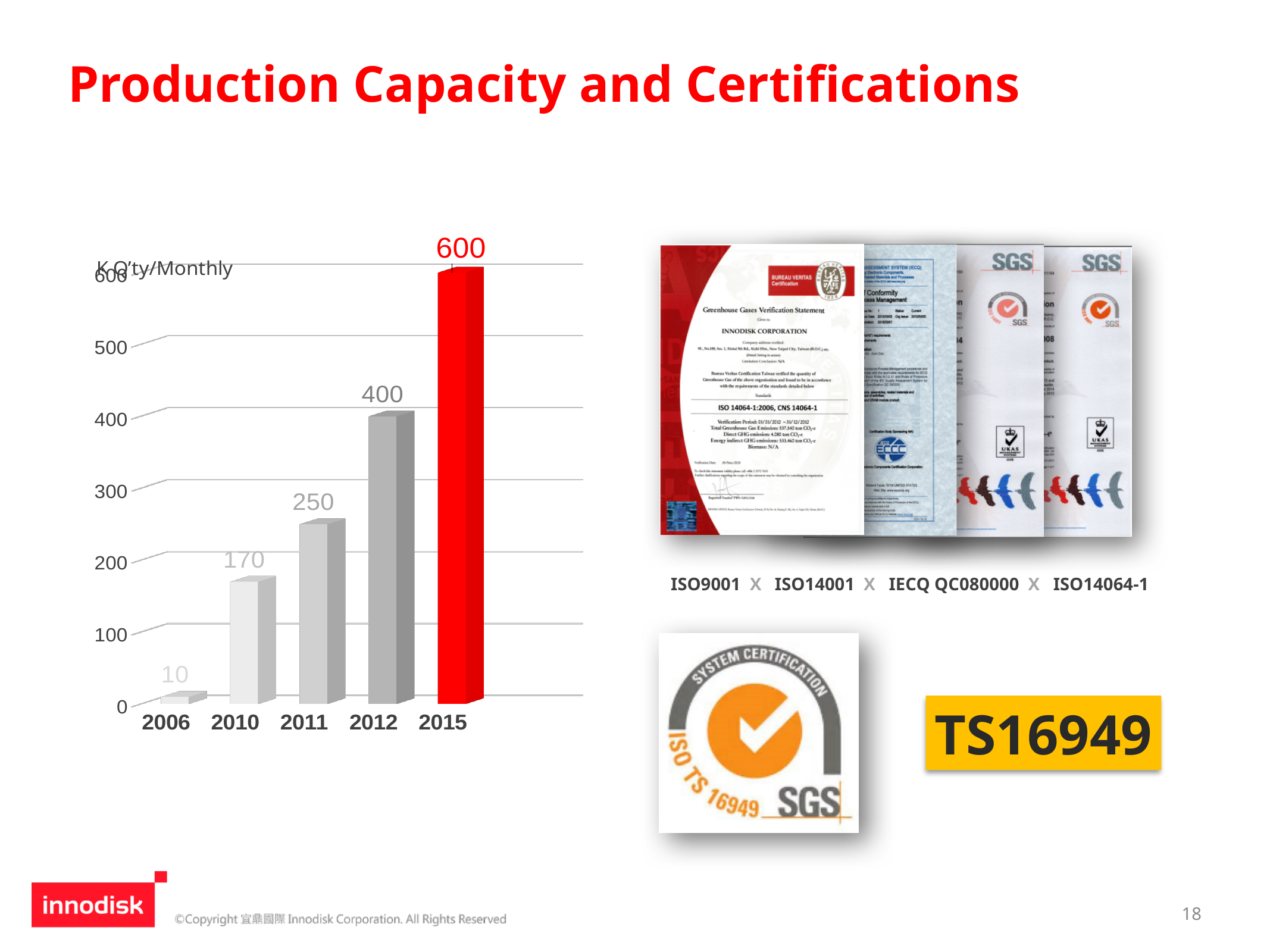
What is the value shown for 2011? 250 How many years are shown on the x axis of the chart? 5 What is the value shown for 2006? 10 Which year has the lowest production capacity? 2006 What is the value shown for 2010? 170 What kind of chart is shown on the slide? bar chart Which is larger, the value for 2011 or the value for 2010? 2011 Do the values rise or fall from 2006 to 2015? rise What is the production capacity value shown for 2012? 400 What is the difference between the values for 2011 and 2010? 80 What is the difference between the values for 2015 and 2012? 200 Which year has the highest production capacity? 2015